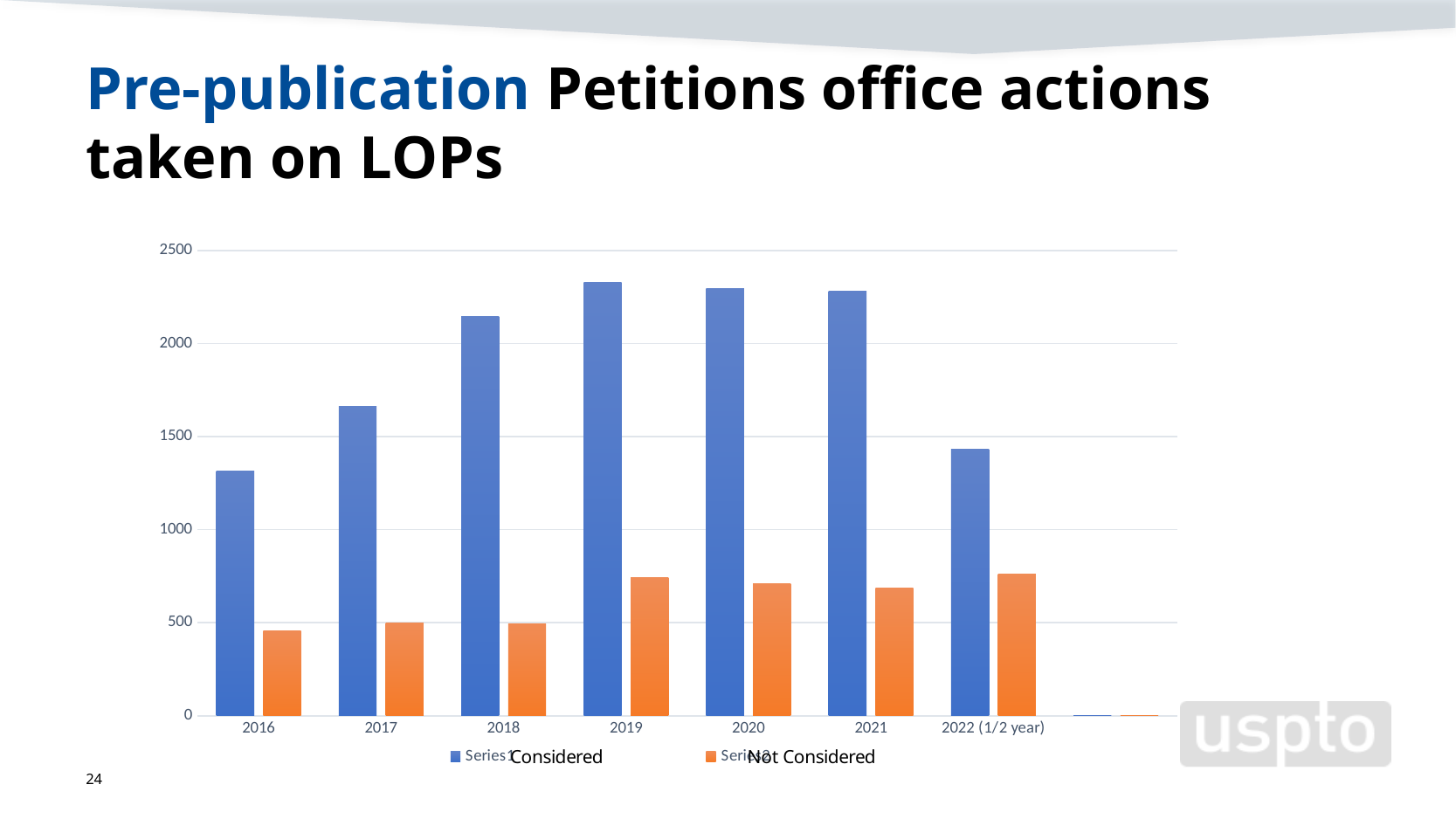
Is the Considered value for 2016 greater or less than 1000? greater Which year has the lowest Considered value? 2016 Which is larger, the Considered value for 2019 or the Considered value for 2016? 2019 Do the Considered values rise or fall from 2016 to 2019? rise Is the Not Considered value for 2019 greater or less than 500? greater Is the Considered value for 2017 greater or less than 2000? less Which is larger, the Not Considered value for 2020 or the Not Considered value for 2017? 2020 How many year categories are shown on the x axis? 7 What kind of chart is shown on the slide? bar chart How many series does the legend list? 2